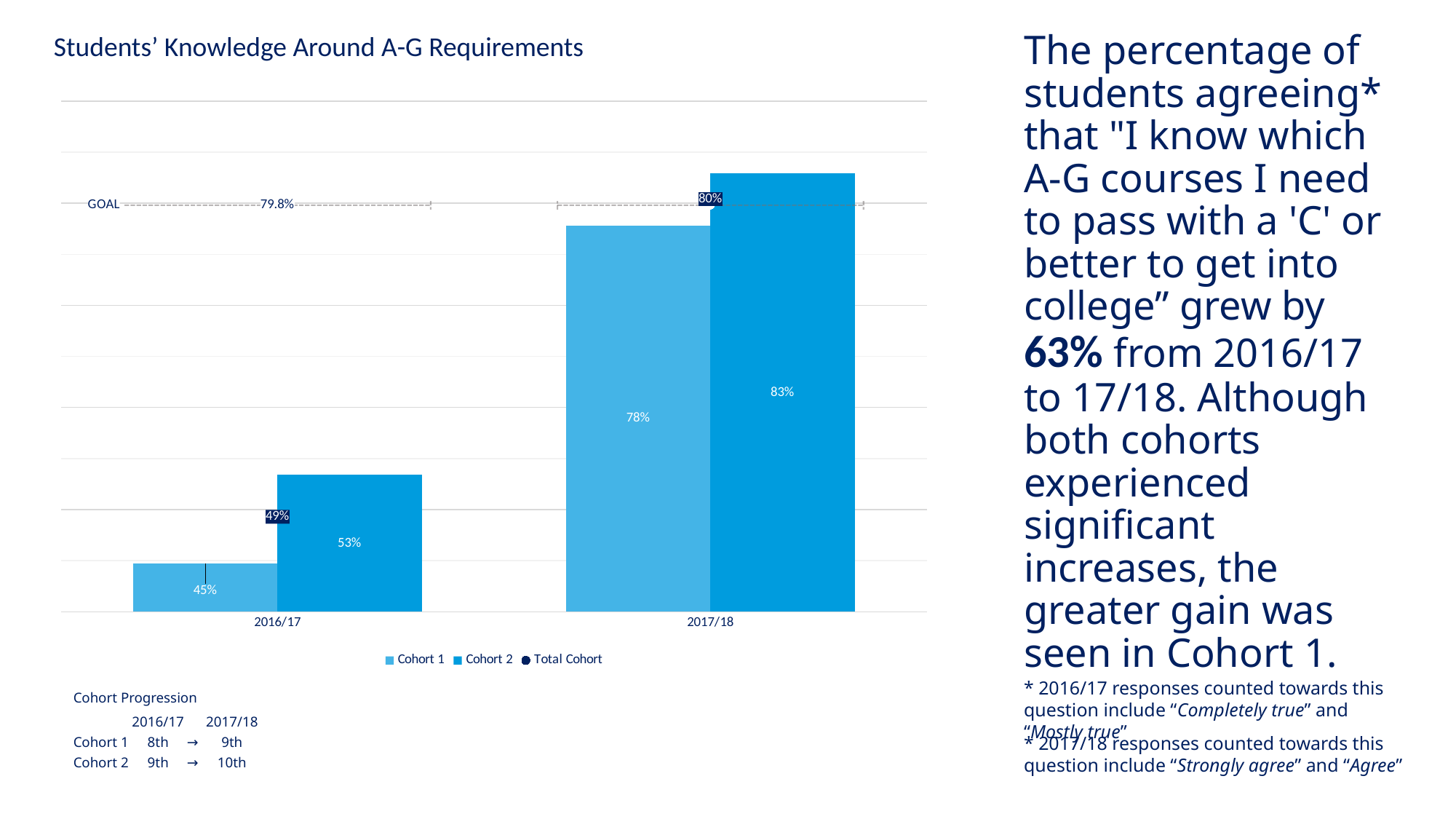
What is the value for Cohort 1 in 2016/17? 45% What is the Total Cohort value for 2016/17? 49% What is the value for Cohort 2 in 2017/18? 83% Which cohort has the highest value in 2017/18? Cohort 2 What is the Total Cohort value for 2017/18? 80% How many series does the legend list? 3 Which cohort has the lowest value in 2016/17? Cohort 1 What is the GOAL value shown on the chart? 79.8% Which is larger: Cohort 2 in 2016/17 or Cohort 1 in 2017/18? Cohort 1 in 2017/18 How many year categories are shown on the x axis? 2 What is the difference between Cohort 1's values in 2017/18 and 2016/17? 33% What kind of chart is shown on the slide? Bar chart